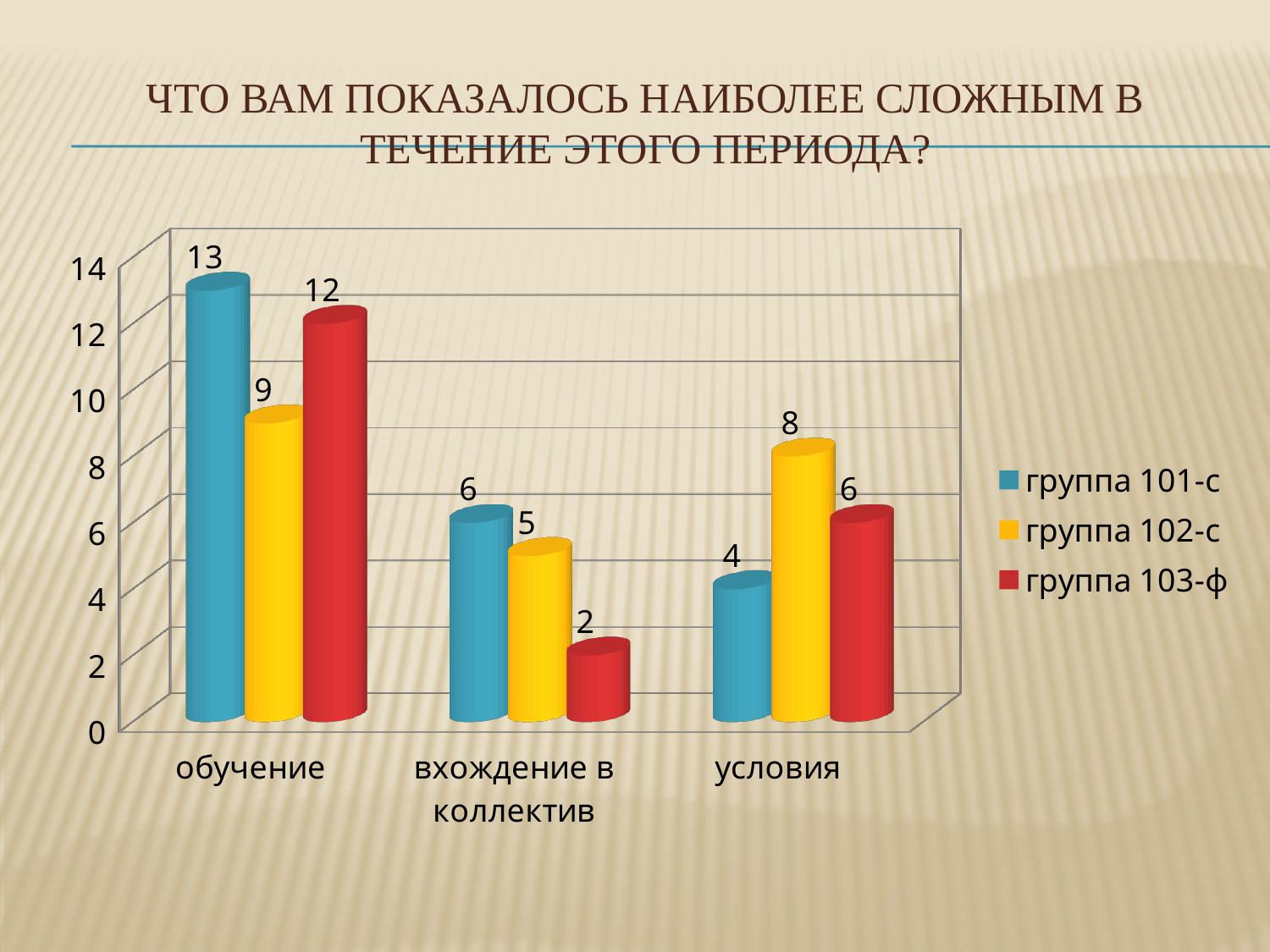
How many series does the legend list? 3 What is the value for группа 103-ф in the вхождение в коллектив category? 2 What kind of chart is shown on the slide? bar chart What is the value for группа 102-с in the условия category? 8 Which is larger in the условия category: группа 101-с or группа 103-ф? группа 103-ф Which category has the highest value for группа 102-с? обучение Is the value for группа 103-ф in the обучение category greater or less than 10? greater Which category has the lowest value for группа 101-с? условия How many categories are shown on the x axis? 3 Which series is shown in yellow? группа 102-с What is the value for группа 101-с in the обучение category? 13 What is the difference between the values for группа 101-с and группа 102-с in the обучение category? 4